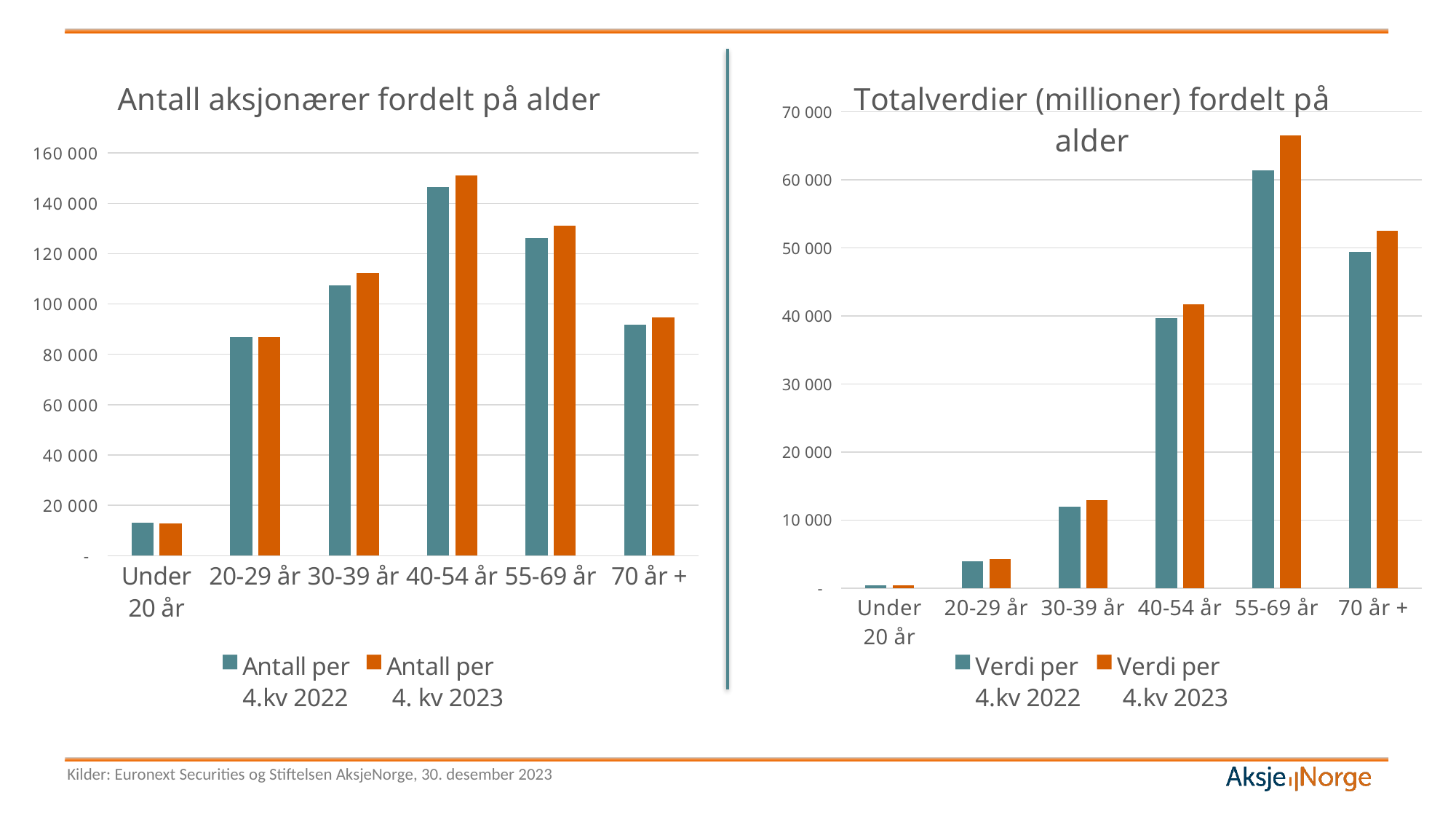
In the chart titled "Totalverdier (millioner) fordelt på alder", what colour are the bars for Verdi per 4.kv 2023? Orange In the chart titled "Antall aksjonærer fordelt på alder", how many age groups are shown on the x axis? 6 What kind of chart is the chart titled "Totalverdier (millioner) fordelt på alder"? Bar chart In the chart titled "Antall aksjonærer fordelt på alder", is the value for 70 år + in Antall per 4. kv 2023 greater or less than 100 000? less In the chart titled "Antall aksjonærer fordelt på alder", which age group has the lowest number of shareholders? Under 20 år In the chart titled "Totalverdier (millioner) fordelt på alder", which age group has the lowest total value? Under 20 år In the chart titled "Antall aksjonærer fordelt på alder", how many series does the legend list? 2 In the chart titled "Totalverdier (millioner) fordelt på alder", which is larger for 55-69 år: Verdi per 4.kv 2022 or Verdi per 4.kv 2023? Verdi per 4.kv 2023 In the chart titled "Antall aksjonærer fordelt på alder", is the value for 40-54 år in Antall per 4. kv 2023 greater or less than 140 000? greater In the chart titled "Totalverdier (millioner) fordelt på alder", is the value for 55-69 år in Verdi per 4.kv 2023 greater or less than 60 000? greater In the chart titled "Antall aksjonærer fordelt på alder", which age group has the highest number of shareholders? 40-54 år In the chart titled "Totalverdier (millioner) fordelt på alder", which age group has the highest total value? 55-69 år